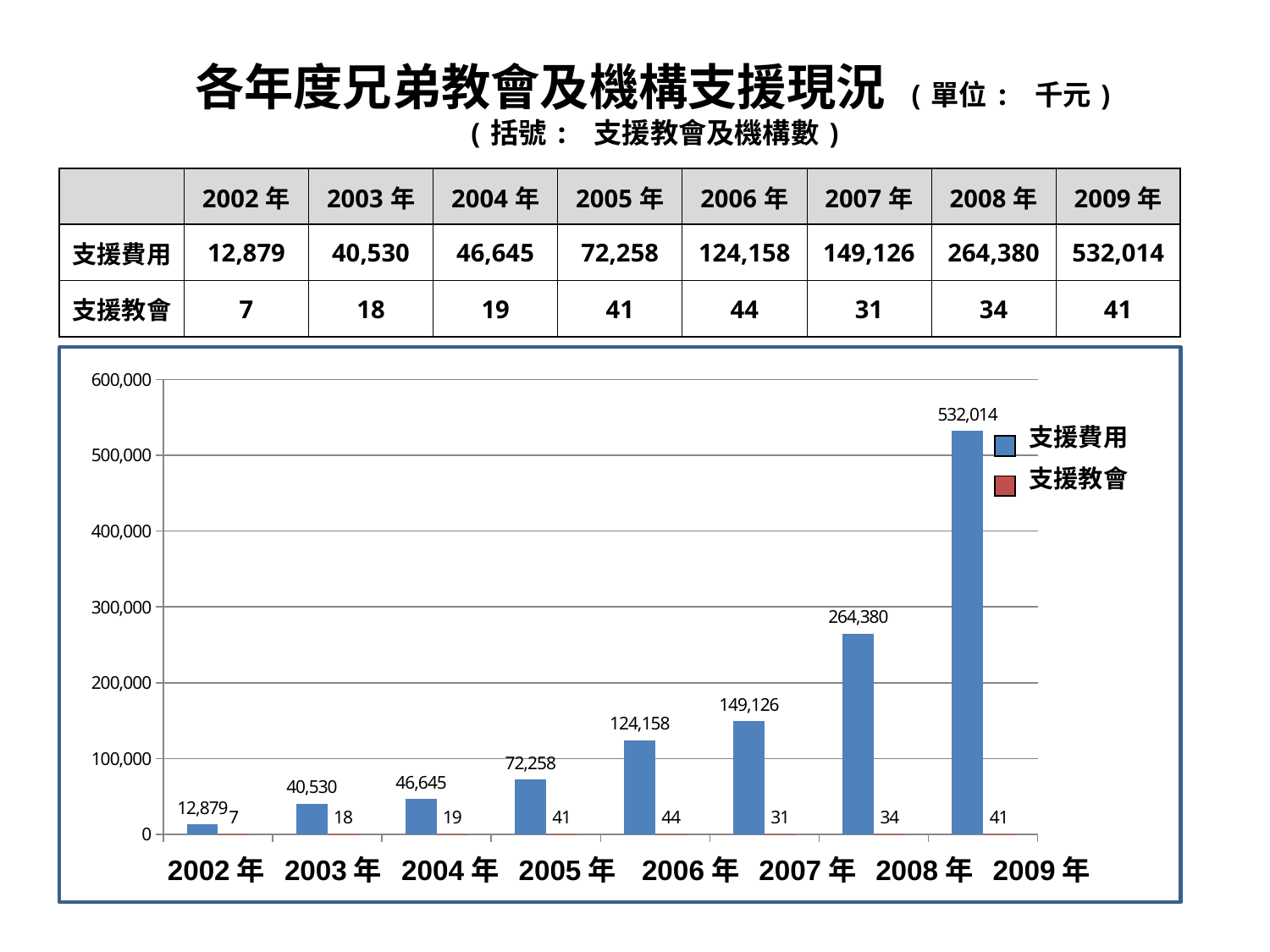
Which is larger, the 支援費用 for 2006 年 or for 2007 年? 2007 年 Which year has the lowest 支援費用? 2002 年 What is the 支援費用 value for 2009 年? 532,014 What is the 支援教會 value for 2006 年? 44 Is the 支援費用 value for 2008 年 greater or less than 300,000? less Does the 支援費用 series rise or fall from 2002 年 to 2009 年? rise What is the difference in 支援費用 between 2009 年 and 2008 年? 267,634 What kind of chart is shown on the slide? bar chart What is the 支援費用 value for 2005 年? 72,258 Which year has the highest 支援費用? 2009 年 How many series does the legend list? 2 How many years are shown on the x axis of the chart? 8